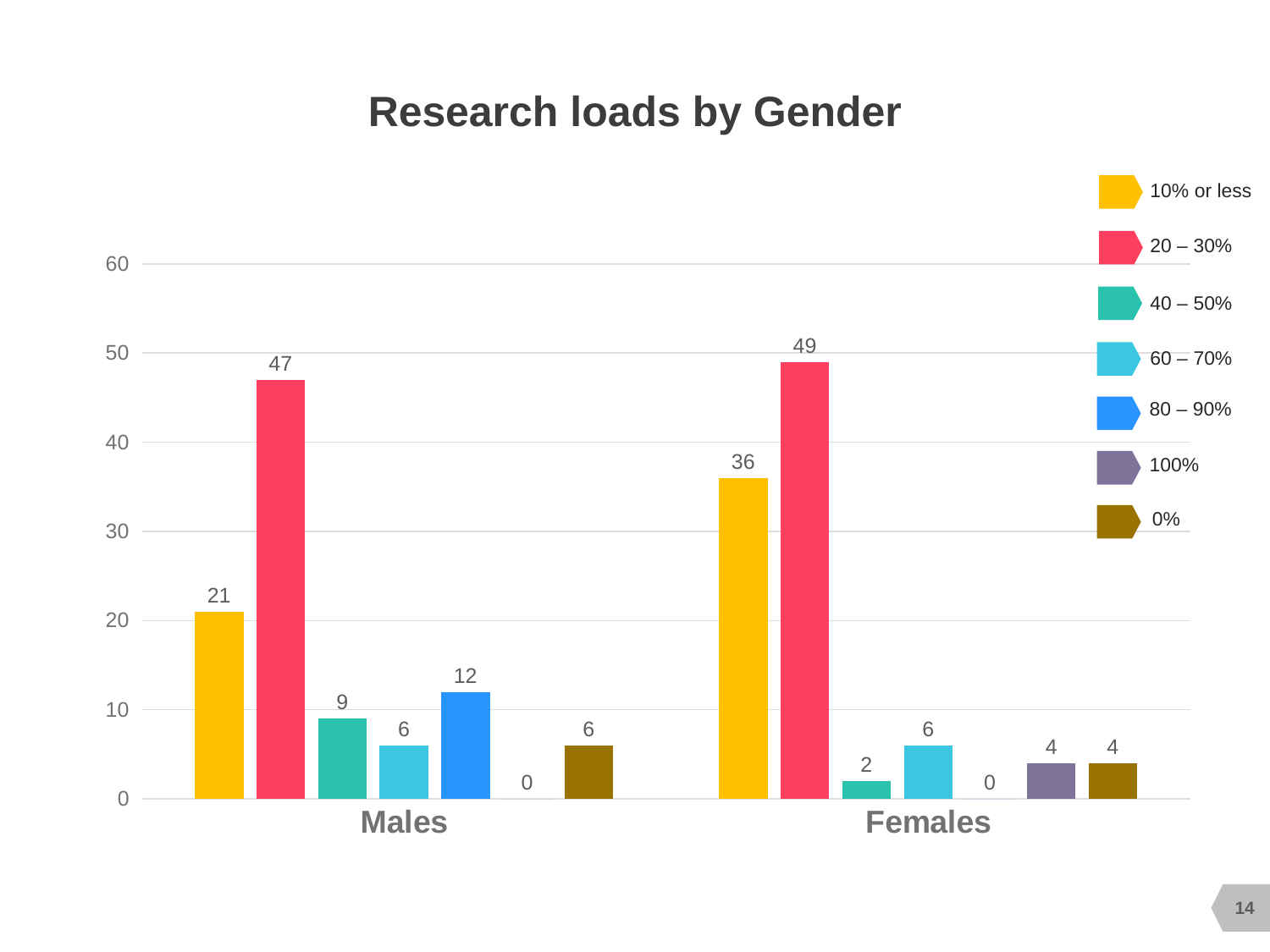
What is the value for the 80 – 90% series for Males? 12 What kind of chart is shown on the slide? Bar chart Which is larger, the 40 – 50% value for Males or for Females? Males Which series has the highest value for Females? 20 – 30% Which series has the lowest value for Males? 100% What is the title of the chart? Research loads by Gender What is the difference between the 10% or less values for Females and Males? 15 What is the value for the 20 – 30% series for Males? 47 What is the difference between the 20 – 30% values for Females and Males? 2 What is the value for the 10% or less series for Females? 36 How many series does the legend list? 7 What is the value for the 100% series for Females? 4